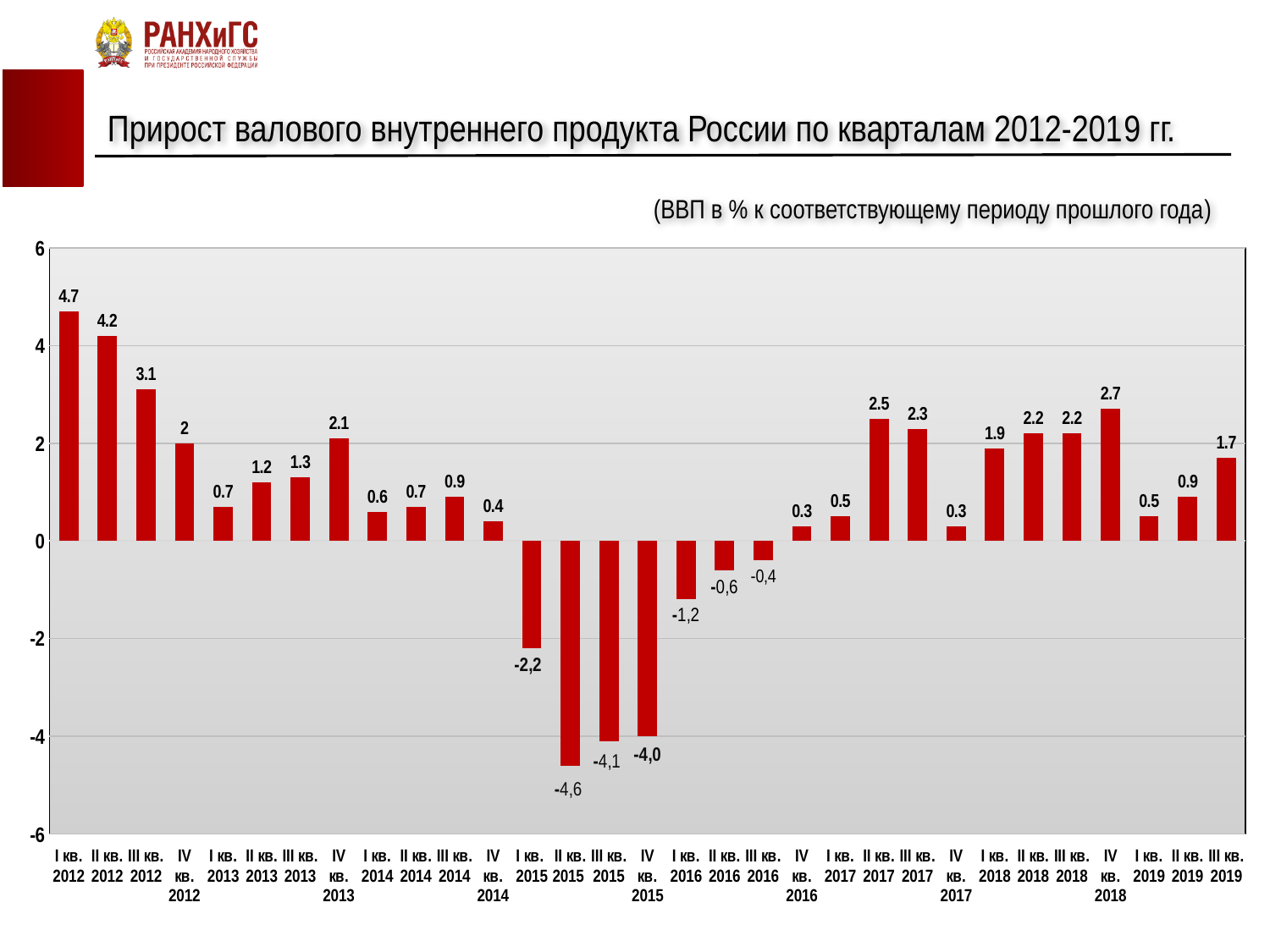
How many quarterly bars are plotted on the chart? 31 What is the GDP growth value for I кв. 2012? 4.7 What is the value shown for II кв. 2015? -4,6 What is the difference between the values for I кв. 2012 and II кв. 2012? 0.5 Which quarter has the highest GDP growth value? I кв. 2012 What is the value shown for III кв. 2019? 1.7 What kind of chart is shown on the slide? bar chart Which is larger, the value for II кв. 2017 or the value for III кв. 2017? II кв. 2017 What is the value shown for IV кв. 2018? 2.7 Is the value for I кв. 2015 greater or less than -2? less Which quarter has the lowest GDP growth value? II кв. 2015 Do the values rise or fall from I кв. 2012 to IV кв. 2012? fall